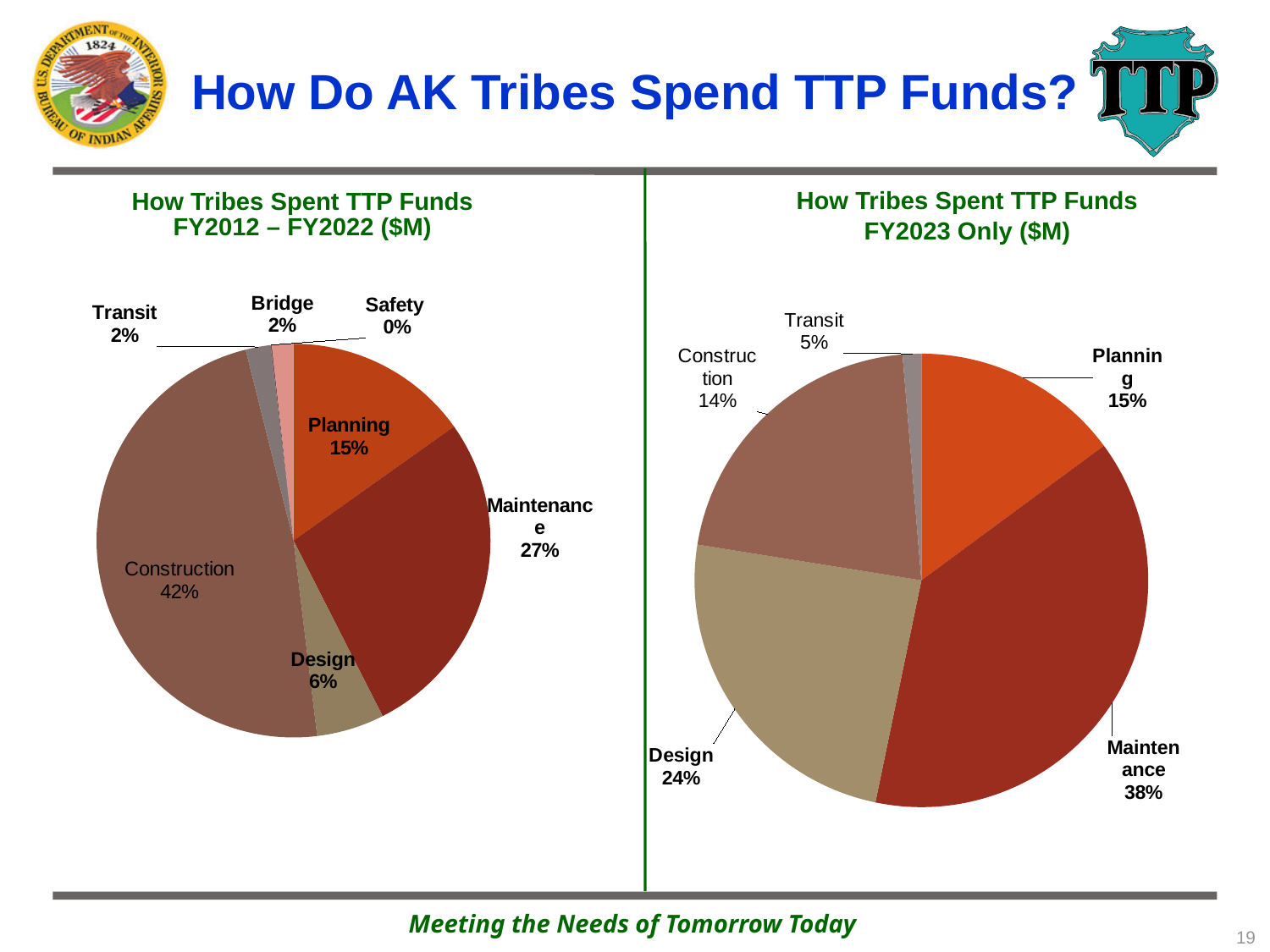
In the 'How Tribes Spent TTP Funds FY2012 – FY2022 ($M)' chart, what is the difference between the Construction and Maintenance shares? 15% In the 'How Tribes Spent TTP Funds FY2023 Only ($M)' chart, what share of funds went to Design? 24% What type of chart is the 'How Tribes Spent TTP Funds FY2023 Only ($M)' chart? Pie chart In the 'How Tribes Spent TTP Funds FY2012 – FY2022 ($M)' chart, which category has the largest share? Construction How many categories are shown in the 'How Tribes Spent TTP Funds FY2023 Only ($M)' chart? 5 In the 'How Tribes Spent TTP Funds FY2023 Only ($M)' chart, which category has the largest share? Maintenance In the 'How Tribes Spent TTP Funds FY2012 – FY2022 ($M)' chart, what share of funds went to Construction? 42% In the 'How Tribes Spent TTP Funds FY2023 Only ($M)' chart, which is larger, the Construction share or the Design share? Design In the 'How Tribes Spent TTP Funds FY2012 – FY2022 ($M)' chart, which category has the smallest share? Safety In the 'How Tribes Spent TTP Funds FY2012 – FY2022 ($M)' chart, what share of funds went to Maintenance? 27% How many categories are shown in the 'How Tribes Spent TTP Funds FY2012 – FY2022 ($M)' chart? 7